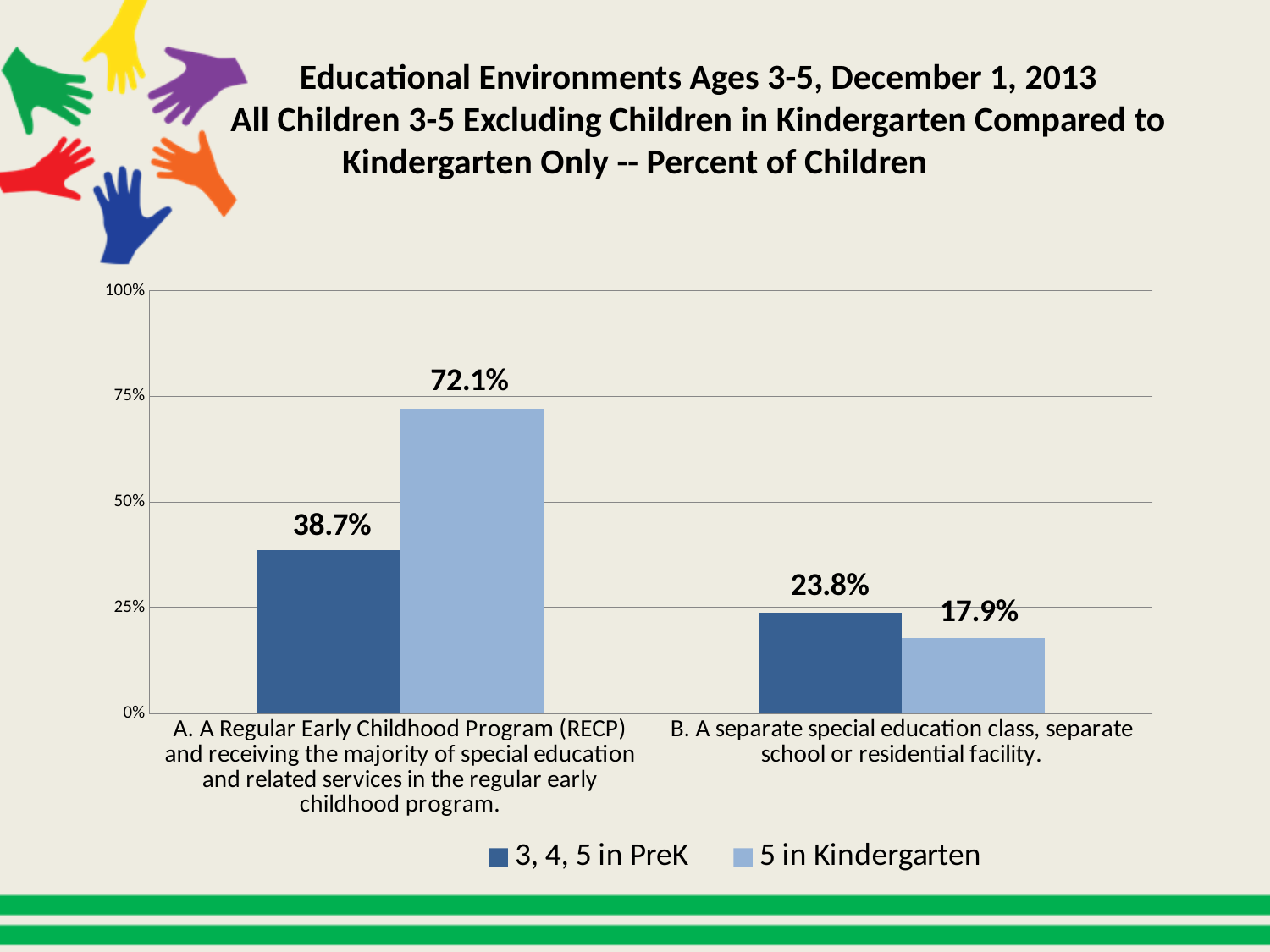
What kind of chart is shown on the slide? Bar chart How many series does the legend list? 2 What is the value for "3, 4, 5 in PreK" in category B (A separate special education class, separate school or residential facility)? 23.8% Which bar has the lowest value on the chart? 5 in Kindergarten, category B (17.9%) What is the difference between the "5 in Kindergarten" and "3, 4, 5 in PreK" values in category A? 33.4% What is the value for "3, 4, 5 in PreK" in category A (A Regular Early Childhood Program)? 38.7% In category B, which series has the larger value: "3, 4, 5 in PreK" or "5 in Kindergarten"? 3, 4, 5 in PreK What is the difference between the "3, 4, 5 in PreK" and "5 in Kindergarten" values in category B? 5.9% Which bar has the highest value on the chart? 5 in Kindergarten, category A (72.1%) What is the value for "5 in Kindergarten" in category A (A Regular Early Childhood Program)? 72.1% What is the value for "5 in Kindergarten" in category B (A separate special education class, separate school or residential facility)? 17.9% Is the value for "3, 4, 5 in PreK" in category A greater or less than 50%? less